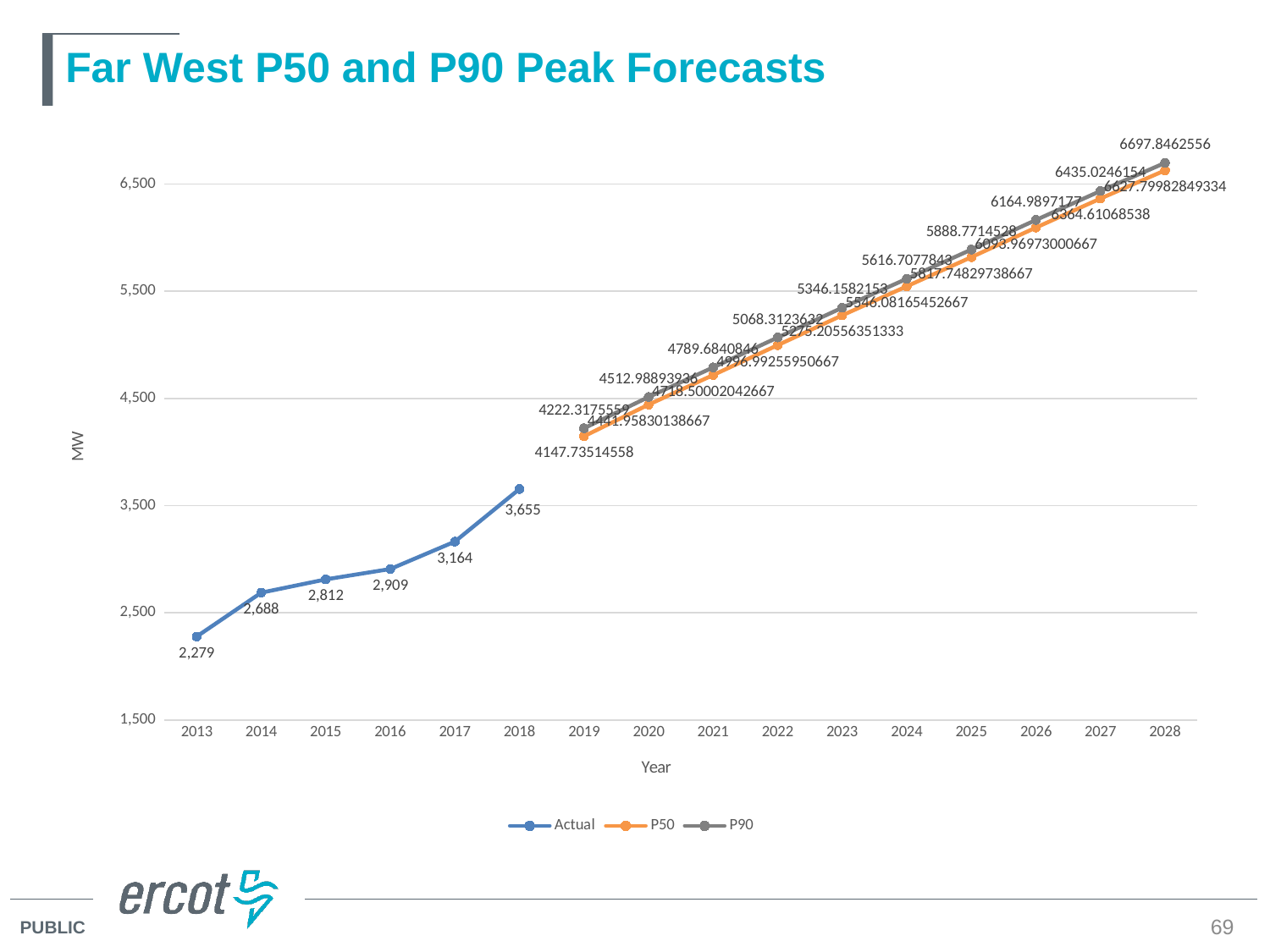
What is the difference between the Actual values for 2018 and 2017? 491 Do the P50 values rise or fall from 2019 to 2028? Rise What is the P90 value for 2028? 6697.8462556 What is the P50 value for 2019? 4147.73514558 How many years are shown on the x axis? 16 Which year has the highest P90 value? 2028 What type of chart is shown on the slide? Line chart Which year has the lowest Actual value? 2013 Which is larger in 2028, the P90 value or the P50 value? P90 What is the Actual value for 2013? 2,279 What is the Actual value for 2018? 3,655 How many series does the legend list? 3